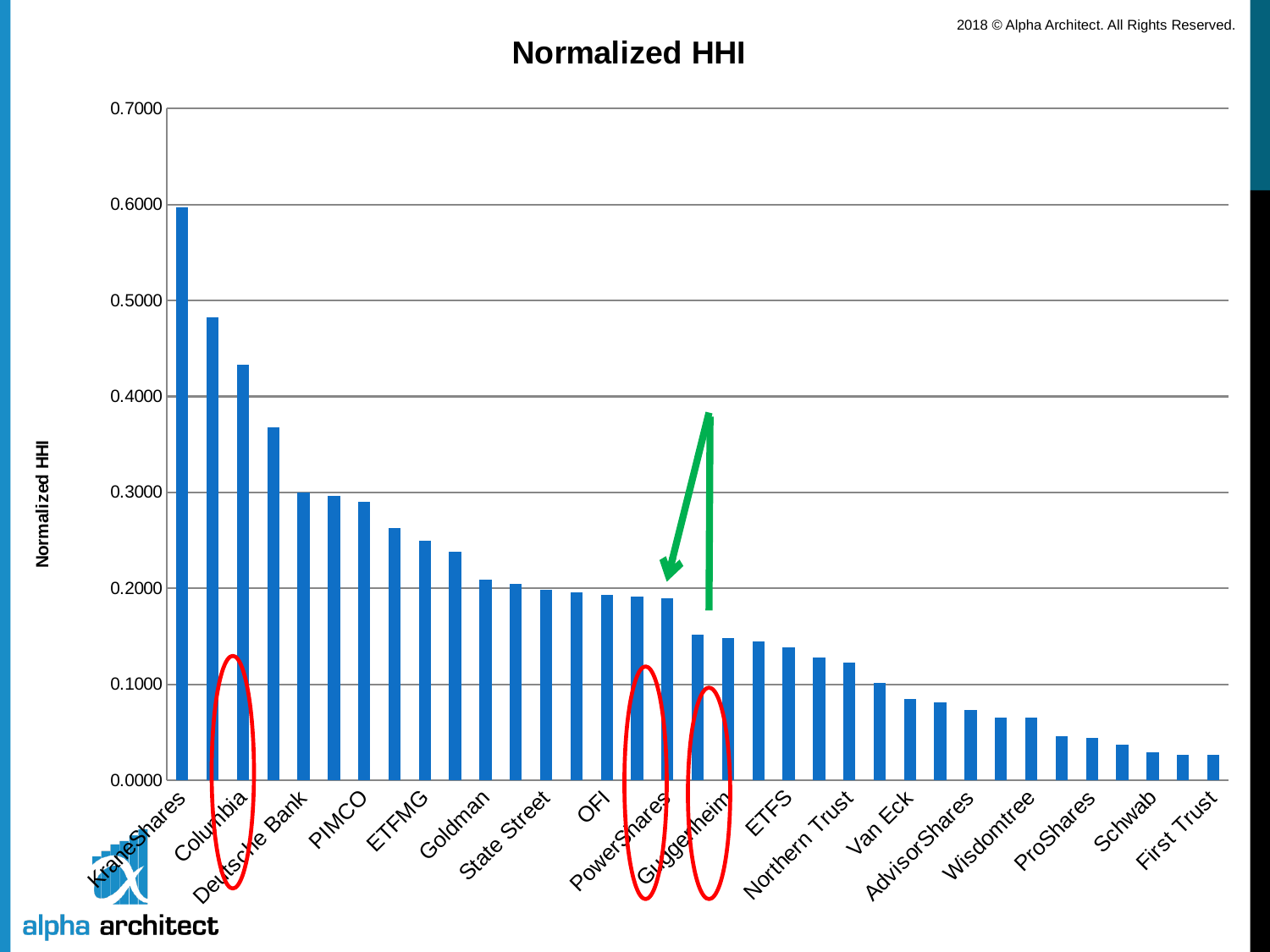
Which category has the highest Normalized HHI? KraneShares Is the value for KraneShares greater or less than 0.5000? greater Which has the larger Normalized HHI, KraneShares or Guggenheim? KraneShares Do the values rise or fall moving from left to right along the x axis? fall Which has the larger Normalized HHI, Columbia or Schwab? Columbia Is the value for Schwab greater or less than 0.1000? less What type of chart is shown on the slide? bar chart Which category has the lowest Normalized HHI? First Trust How many category labels are shown on the x axis? 18 Is the value for ETFMG greater or less than 0.2000? greater What is the title of the chart? Normalized HHI